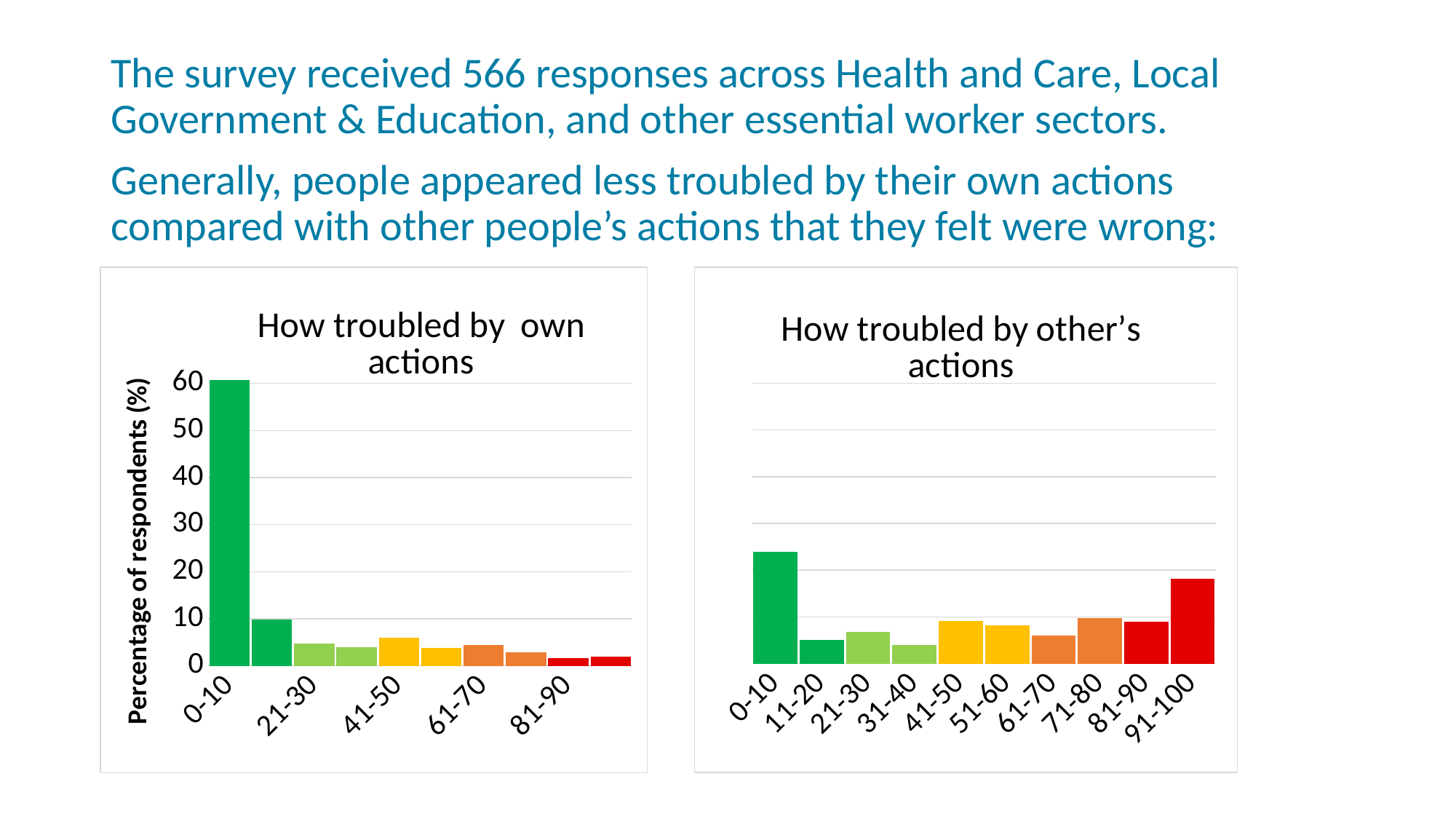
In the "How troubled by own actions" chart, which is larger, the value for 0-10 or the value for 11-20? 0-10 In the "How troubled by own actions" chart, which category has the highest value? 0-10 What kind of chart is "How troubled by own actions"? bar chart In the "How troubled by other's actions" chart, which is larger, the value for 0-10 or the value for 91-100? 0-10 In the "How troubled by other's actions" chart, which is larger, the value for 41-50 or the value for 31-40? 41-50 In the "How troubled by other's actions" chart, which category has the highest value? 0-10 How many bars are plotted in the "How troubled by other's actions" chart? 10 In the "How troubled by own actions" chart, is the value for 0-10 greater or less than 50? greater What is the y-axis title of the "How troubled by own actions" chart? Percentage of respondents (%) In the "How troubled by own actions" chart, do the values generally rise or fall from left to right along the x axis? fall In the "How troubled by own actions" chart, is the value for 21-30 greater or less than 10? less In the "How troubled by own actions" chart, is the value for 61-70 greater or less than 10? less